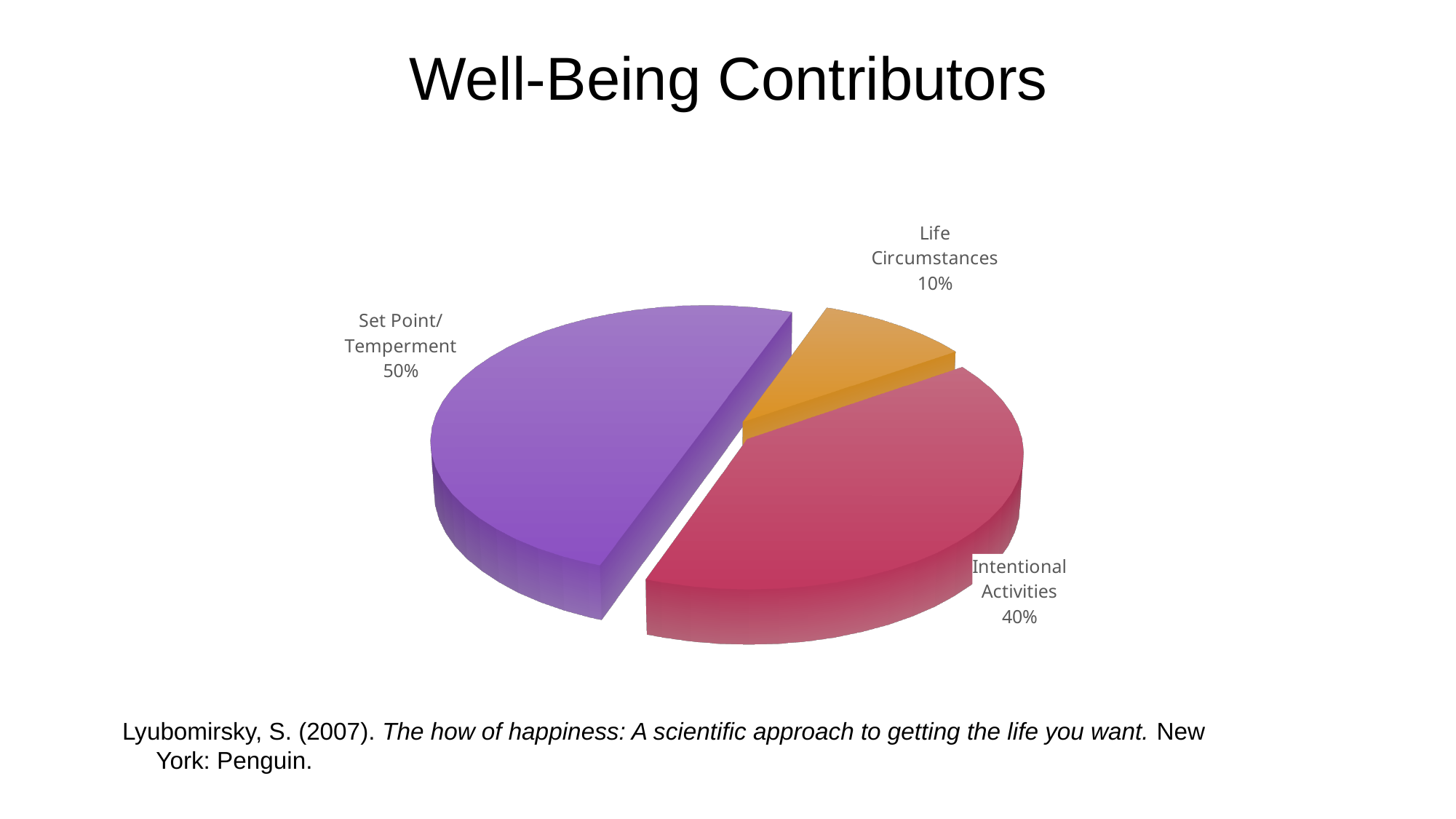
What share of the pie does Set Point/Temperment account for? 50% What kind of chart is shown on the slide? Pie chart Which category has the smallest slice of the pie? Life Circumstances Which category has the largest slice of the pie? Set Point/Temperment What colour is the slice for Life Circumstances? Orange What share of the pie does Life Circumstances account for? 10% What is the difference in percentage points between Set Point/Temperment and Intentional Activities? 10% What is the title of the chart on the slide? Well-Being Contributors What share of the pie does Intentional Activities account for? 40% What is the difference in percentage points between Intentional Activities and Life Circumstances? 30% How many slices does the pie chart have? 3 Which is larger, the slice for Intentional Activities or the slice for Life Circumstances? Intentional Activities